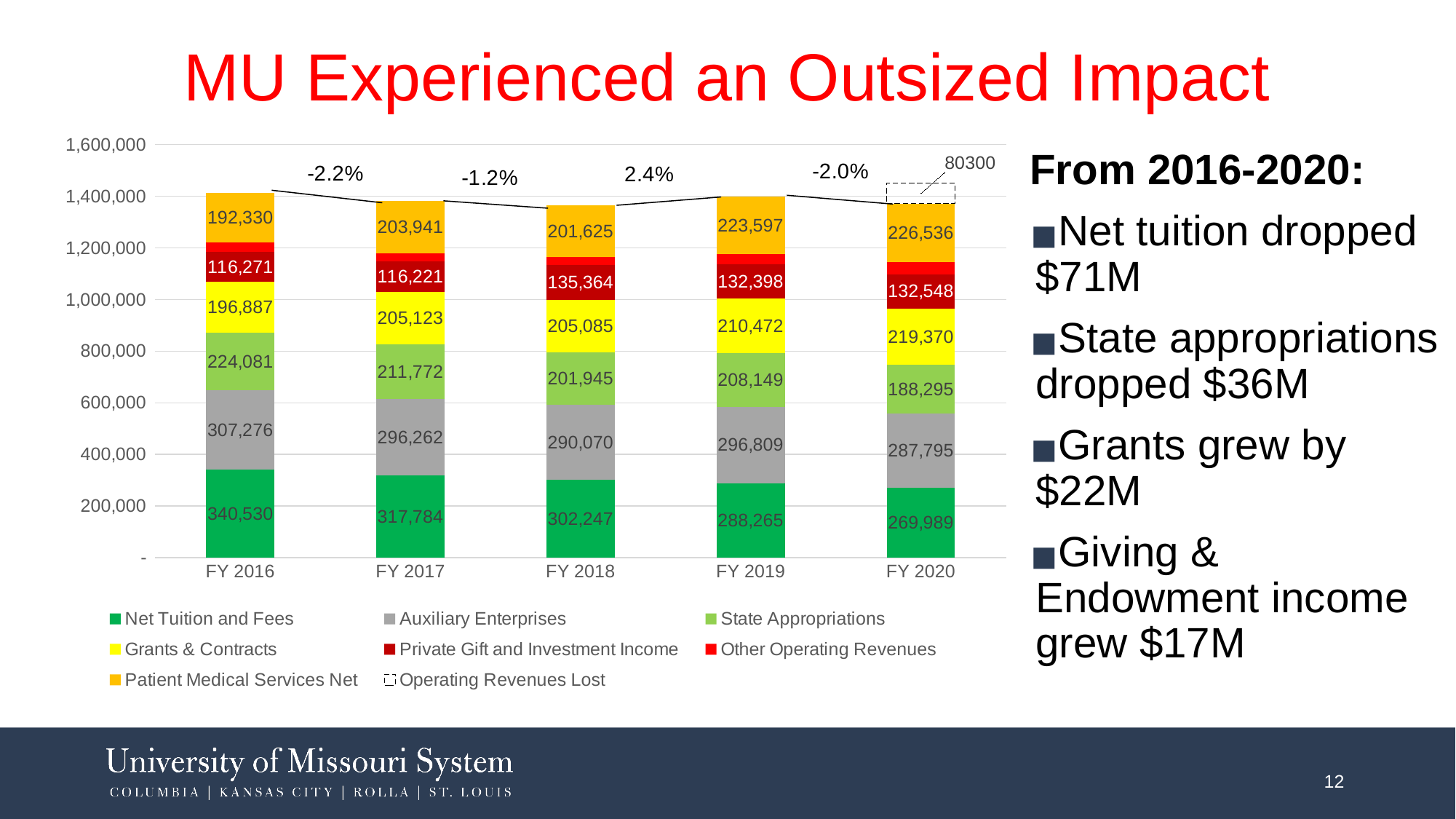
What percentage change is shown between FY 2018 and FY 2019? 2.4% How many series does the legend list? 8 How many fiscal years are shown on the x axis? 5 In which fiscal year is Net Tuition and Fees highest? FY 2016 What value is shown for Operating Revenues Lost in FY 2020? 80300 What is the value of Patient Medical Services Net for FY 2020? 226,536 In which fiscal year is State Appropriations lowest? FY 2020 What is the value of State Appropriations for FY 2018? 201,945 Does Net Tuition and Fees rise or fall from FY 2016 to FY 2020? fall Which is larger in FY 2019: Auxiliary Enterprises or Grants & Contracts? Auxiliary Enterprises What is the value of Net Tuition and Fees for FY 2016? 340,530 By how much did Net Tuition and Fees decrease from FY 2016 to FY 2020? 70,541